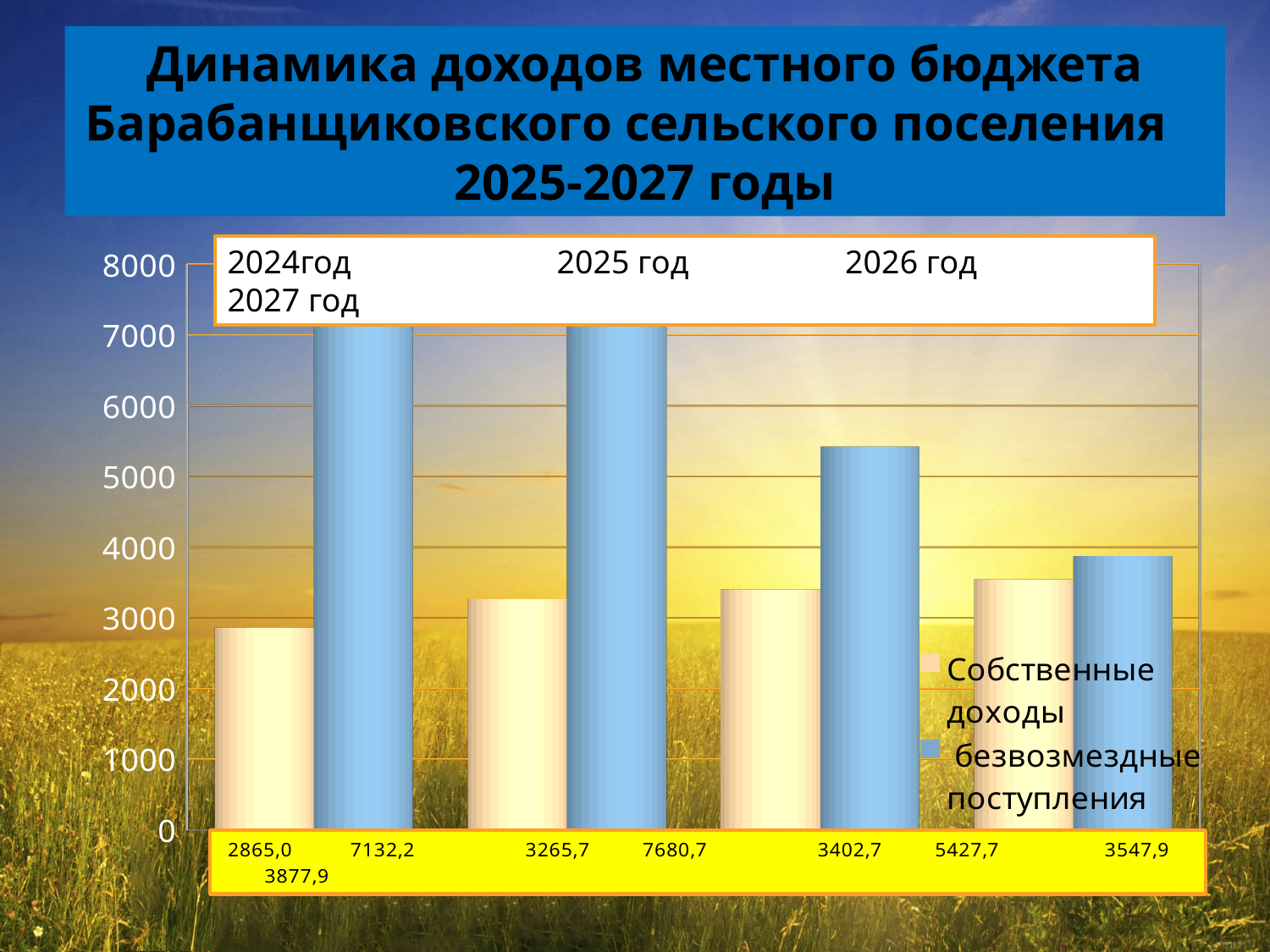
What kind of chart is shown on the slide? bar chart What is the value of безвозмездные поступления for 2025 год? 7680,7 What is the value of Собственные доходы for 2026 год? 3402,7 What is the value of безвозмездные поступления for 2027 год? 3877,9 What is the difference between безвозмездные поступления and Собственные доходы in 2026 год? 2025,0 In which year are безвозмездные поступления the highest? 2025 год What is the value of Собственные доходы for 2024 год? 2865,0 How many series does the legend list? 2 Do Собственные доходы rise or fall from 2024 год to 2027 год? rise Which is larger in 2027 год: Собственные доходы or безвозмездные поступления? безвозмездные поступления In which year are Собственные доходы the lowest? 2024 год How many years are shown on the x axis of the chart? 4